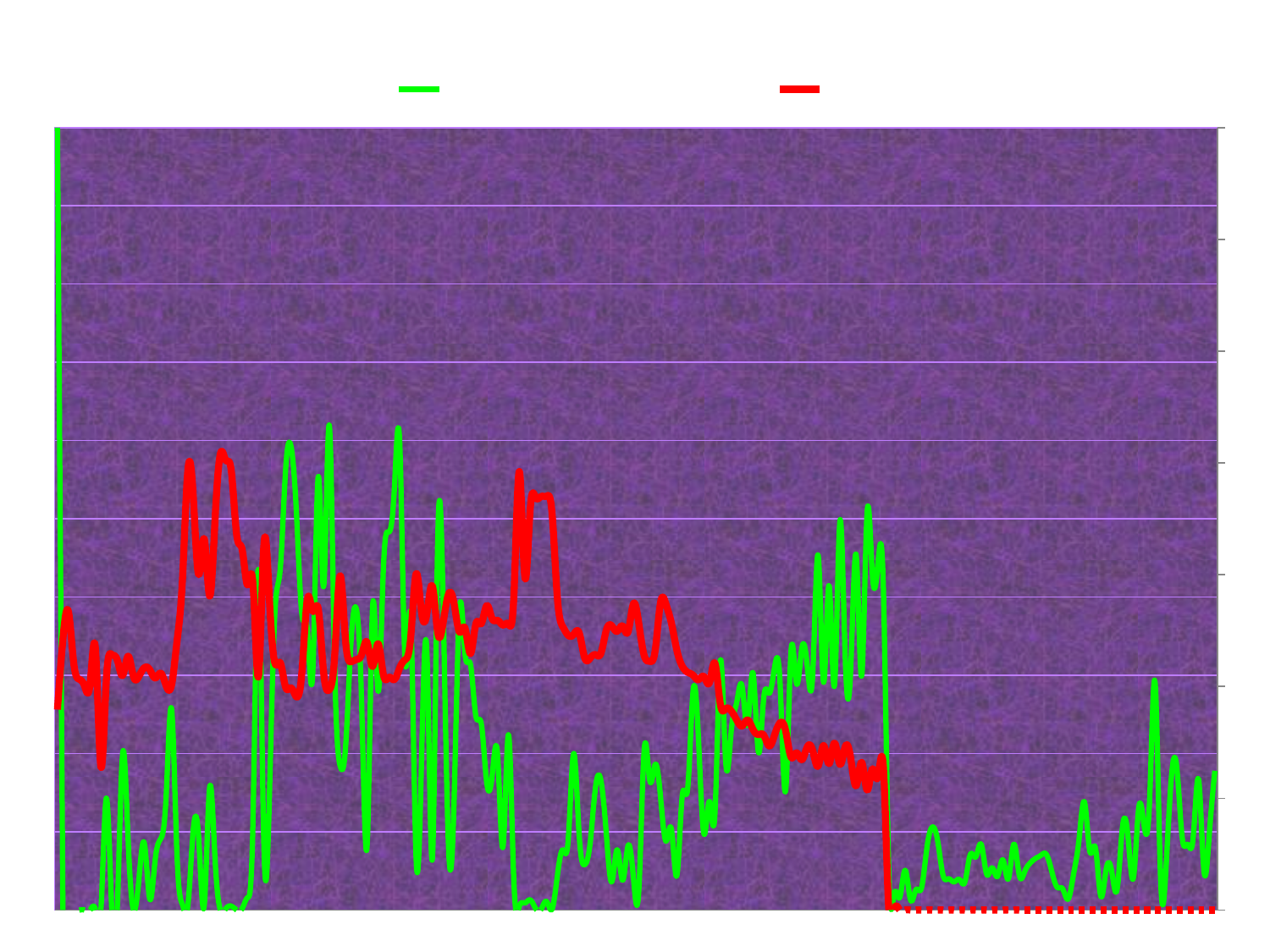
How many series does the legend list? 2 What kind of chart is shown on the slide? line chart Does the red line end higher or lower at the right edge of the chart than where it starts at the left edge? lower What colours are the two lines plotted on the chart? green and red